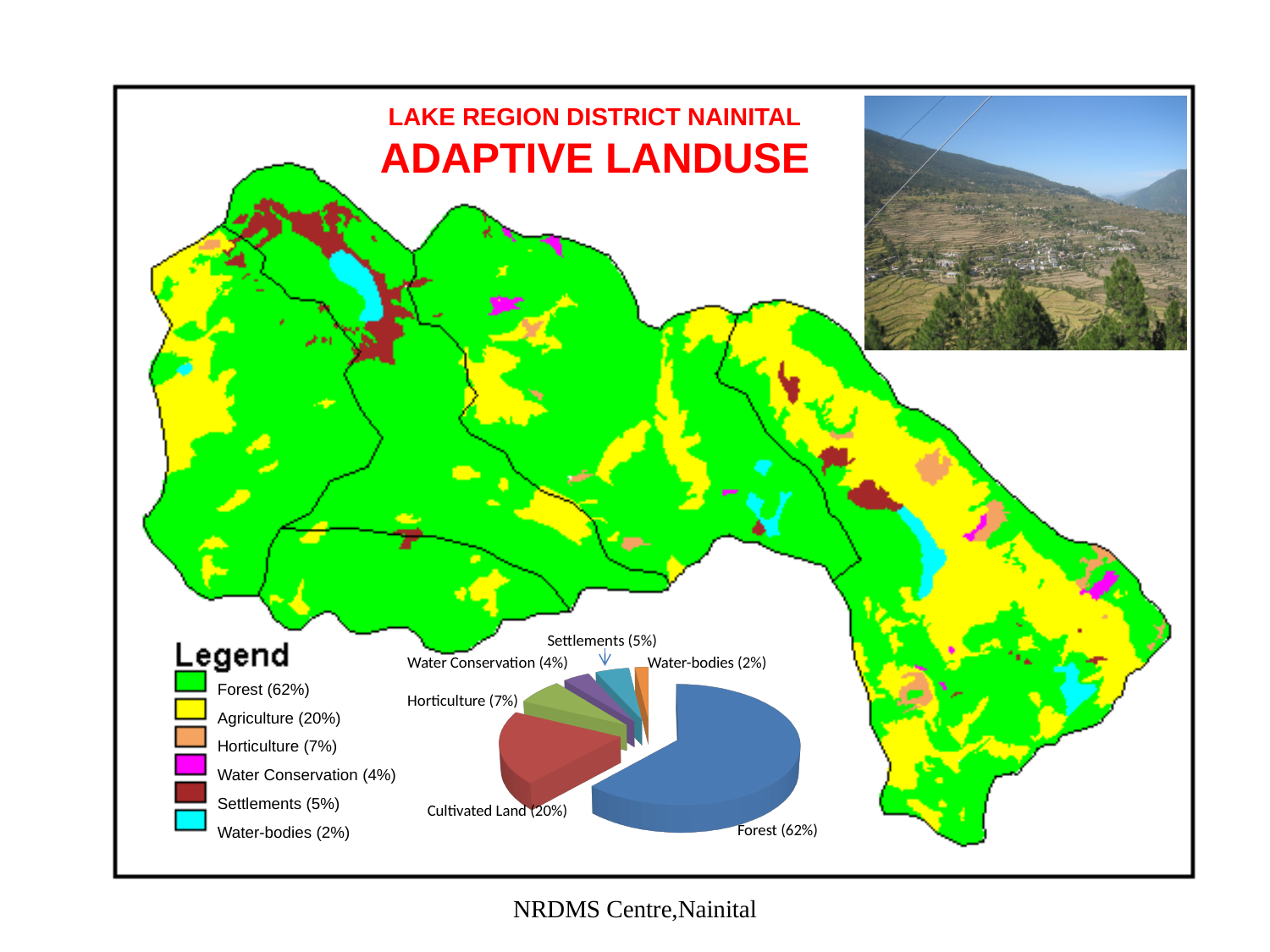
What is the difference in percentage points between Forest and Cultivated Land in the pie chart? 42 What share of the pie chart does Cultivated Land represent? 20% What kind of chart is shown on the slide? pie chart What share of the pie chart does Settlements represent? 5% Which is larger in the pie chart, Settlements or Water Conservation? Settlements What share of the pie chart does Horticulture represent? 7% What share of the pie chart does Water Conservation represent? 4% Which category has the largest slice in the pie chart? Forest What share of the pie chart does Water-bodies represent? 2% Which category has the smallest slice in the pie chart? Water-bodies What share of the pie chart does Forest represent? 62% How many slices does the pie chart have? 6